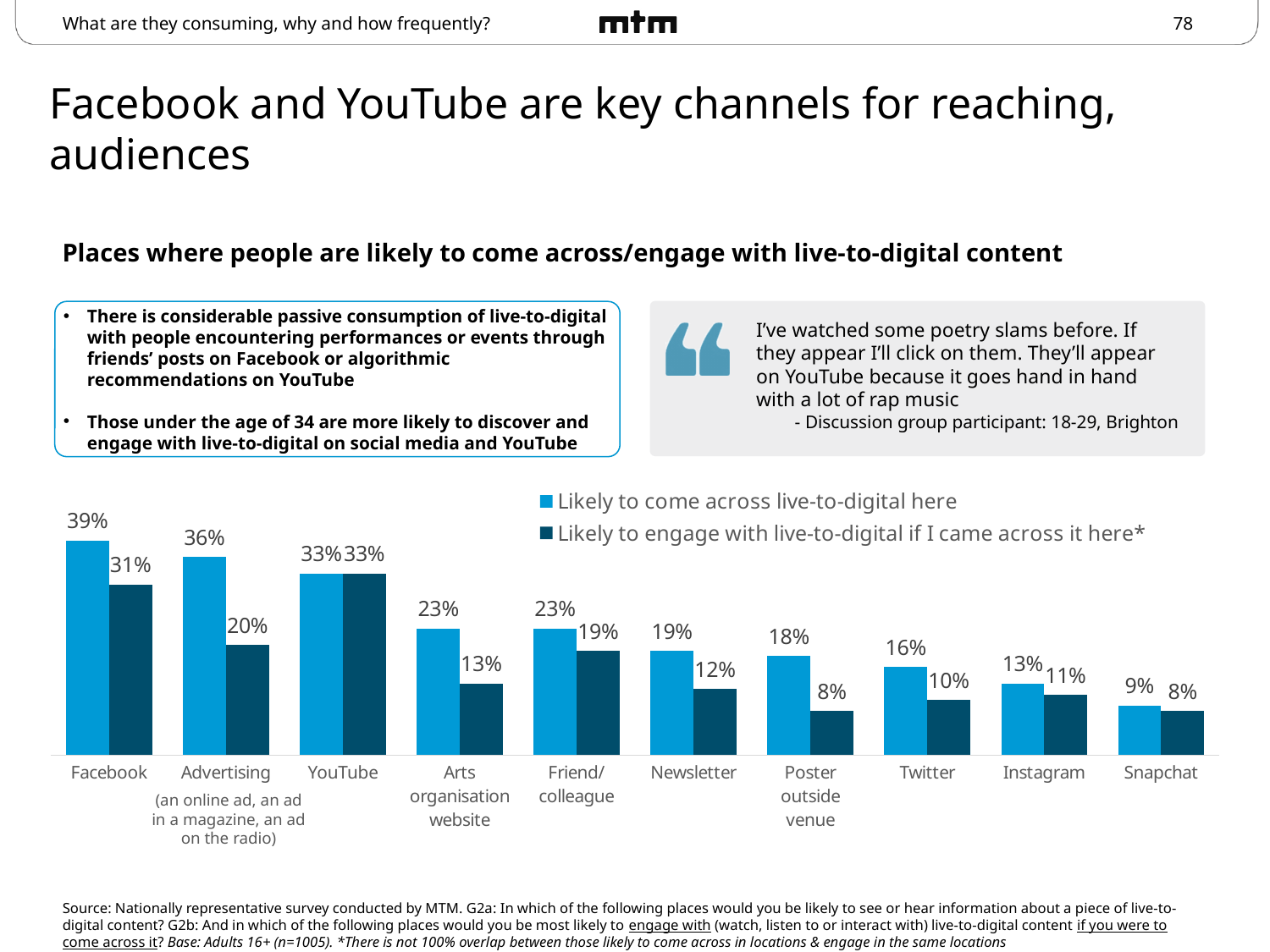
How many places (categories) are shown on the x axis of the chart? 10 Which place has the highest value for 'Likely to come across live-to-digital here'? Facebook What is the difference between the 'likely to come across' and 'likely to engage' values for Poster outside venue? 10% What is the value for 'Likely to engage with live-to-digital if I came across it here' for Advertising? 20% How many series does the chart's legend list? 2 Do the 'Likely to come across live-to-digital here' values generally rise or fall from Facebook to Snapchat along the x axis? Fall What type of chart is used to show the places where people come across live-to-digital content? Bar chart What percentage of people are likely to engage with live-to-digital content on Twitter if they came across it there? 10% Which is larger: the 'Likely to come across live-to-digital here' value for Advertising or for YouTube? Advertising What percentage of people are likely to come across live-to-digital content on Facebook? 39% Which place has the lowest value for 'Likely to come across live-to-digital here'? Snapchat For which place are the 'likely to come across' and 'likely to engage' values equal? YouTube